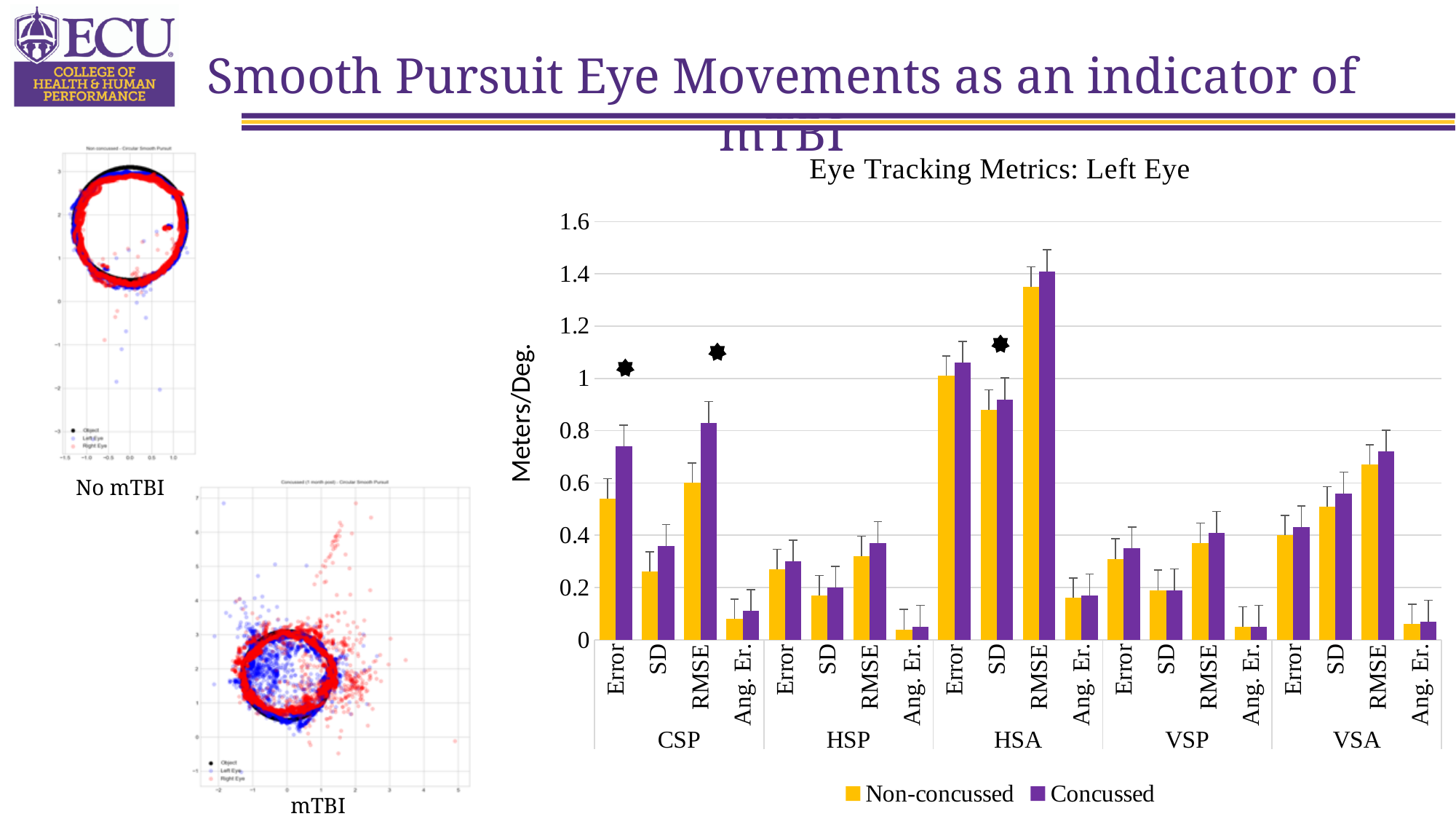
How many task groups (CSP, HSP, etc.) are shown along the x axis of the 'Eye Tracking Metrics: Left Eye' chart? 5 What are the two legend entries in the 'Eye Tracking Metrics: Left Eye' chart? Non-concussed and Concussed What is the y-axis label of the 'Eye Tracking Metrics: Left Eye' chart? Meters/Deg. In the 'Eye Tracking Metrics: Left Eye' chart, which group and metric has the tallest bar? HSA RMSE In the 'Eye Tracking Metrics: Left Eye' chart, is the Non-concussed value for HSA RMSE greater or less than 1.2? greater How many metrics are plotted within each task group in the 'Eye Tracking Metrics: Left Eye' chart? 4 How many series does the legend of the 'Eye Tracking Metrics: Left Eye' chart list? 2 In the 'Eye Tracking Metrics: Left Eye' chart, is the Concussed value for CSP Error greater or less than 0.6? greater In the 'Eye Tracking Metrics: Left Eye' chart, for CSP RMSE, which series has the larger value: Non-concussed or Concussed? Concussed What kind of chart is 'Eye Tracking Metrics: Left Eye'? bar chart In the 'Eye Tracking Metrics: Left Eye' chart, which Non-concussed Error bar is larger: HSA or CSP? HSA In the 'Eye Tracking Metrics: Left Eye' chart, is the Non-concussed value for VSA SD greater or less than 0.4? greater